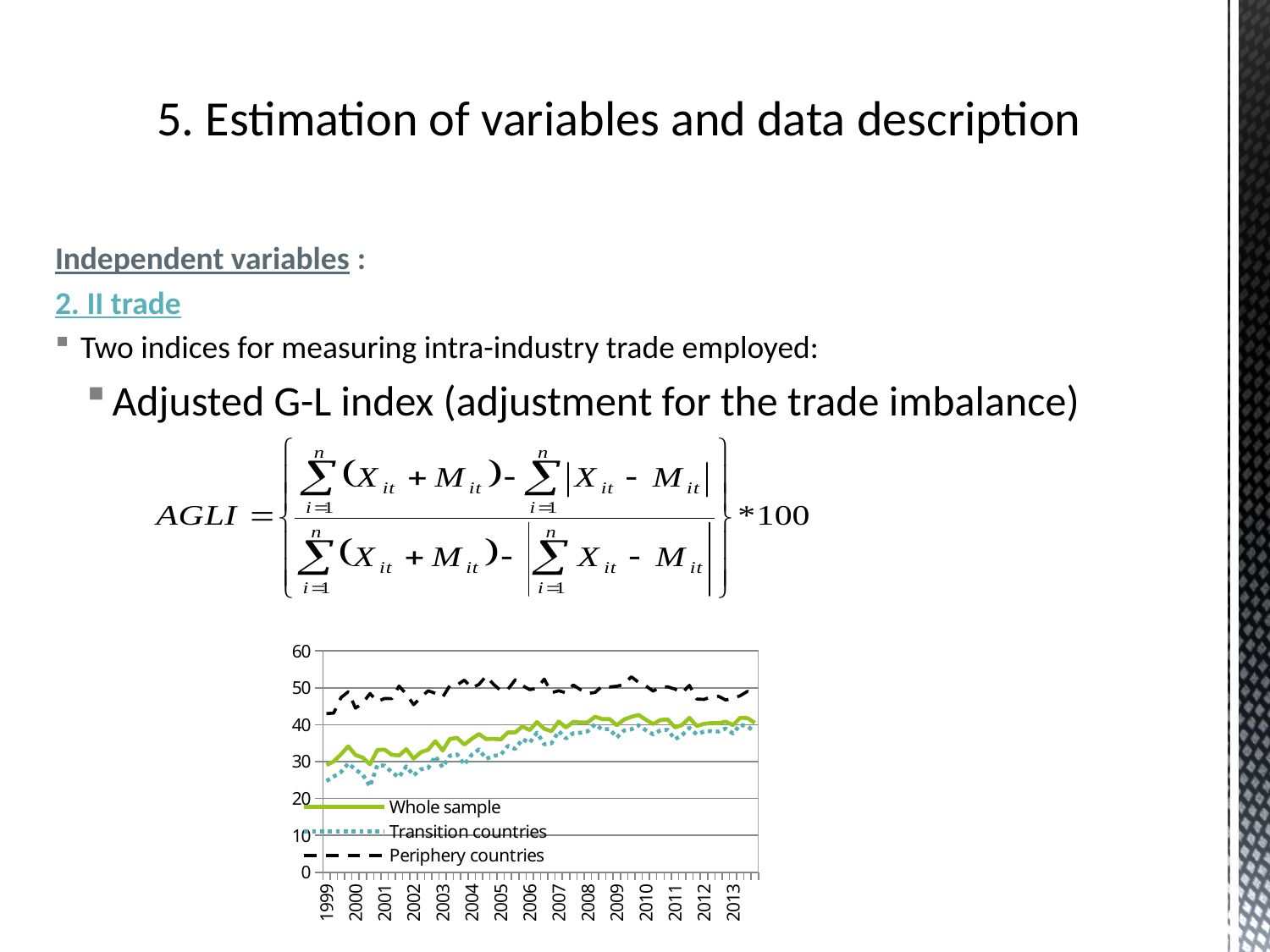
Which series is drawn with a dashed black line? Periphery countries Do the values for Transition countries rise or fall from 1999 to 2013? rise Which series has the lowest values across the whole period shown? Transition countries What kind of chart is shown on the slide? line chart How many year labels are shown on the x axis? 15 Which series has the highest values across the whole period shown? Periphery countries Is the value for Periphery countries in 2013 greater or less than 40? greater Is the value for Transition countries in 1999 greater or less than 30? less Is the value for Periphery countries in 1999 greater or less than 40? greater Which series are listed in the chart's legend? Whole sample, Transition countries, Periphery countries How many series does the chart's legend list? 3 In 1999, which is larger: the value for Periphery countries or the value for Transition countries? Periphery countries